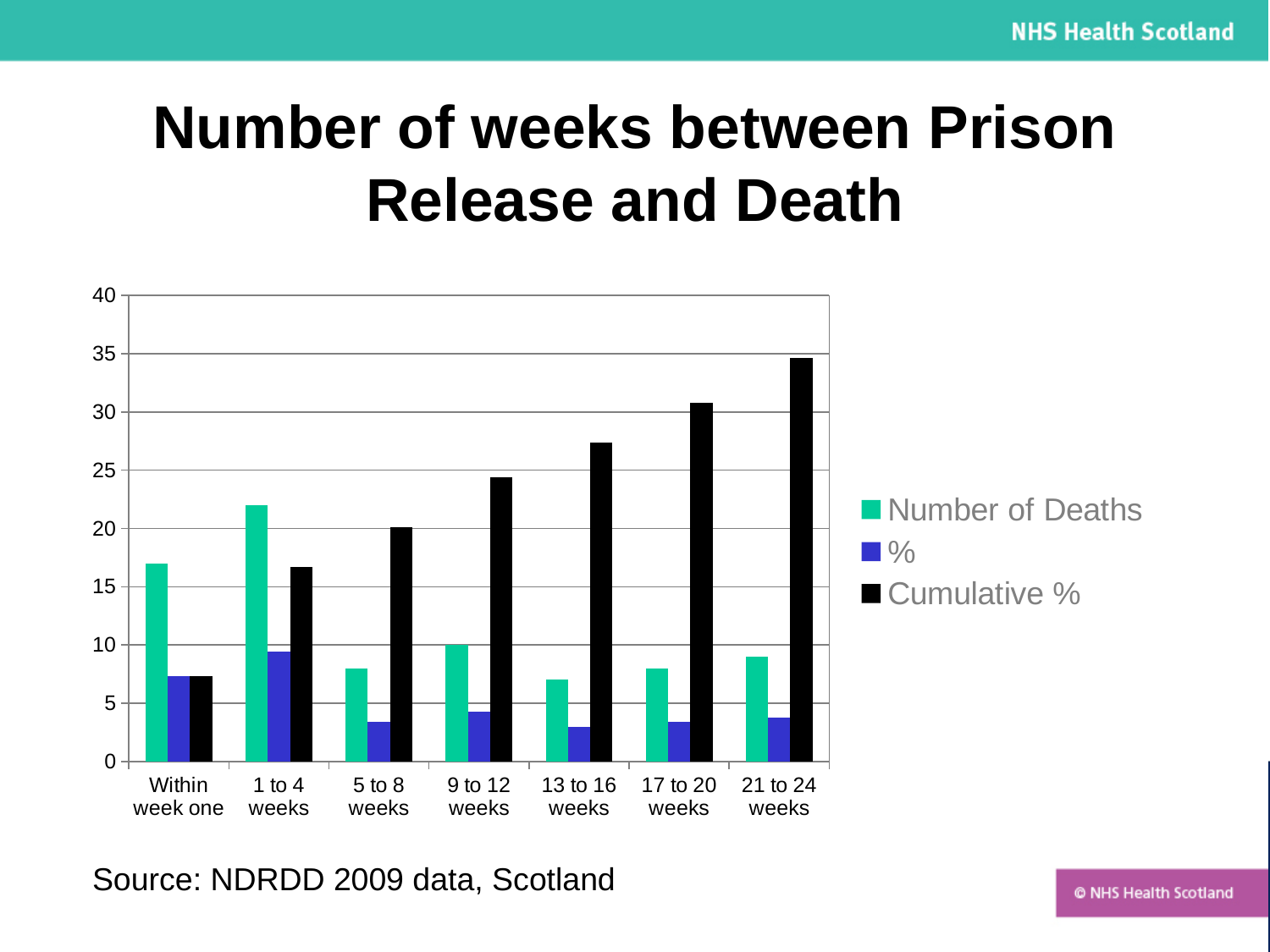
Which has a higher Number of Deaths: Within week one or 1 to 4 weeks? 1 to 4 weeks Is the Number of Deaths for 1 to 4 weeks greater or less than 20? greater How many series does the legend list? 3 Which category has the highest Cumulative %? 21 to 24 weeks Does the Cumulative % rise or fall across the categories from left to right? rise Is the Cumulative % for 21 to 24 weeks greater or less than 30? greater What kind of chart is shown on the slide? bar chart What colour represents the Cumulative % series? black Which category has the highest Number of Deaths? 1 to 4 weeks Is the Number of Deaths for Within week one greater or less than 15? greater Which category has the lowest Cumulative %? Within week one How many categories are shown on the x axis? 7